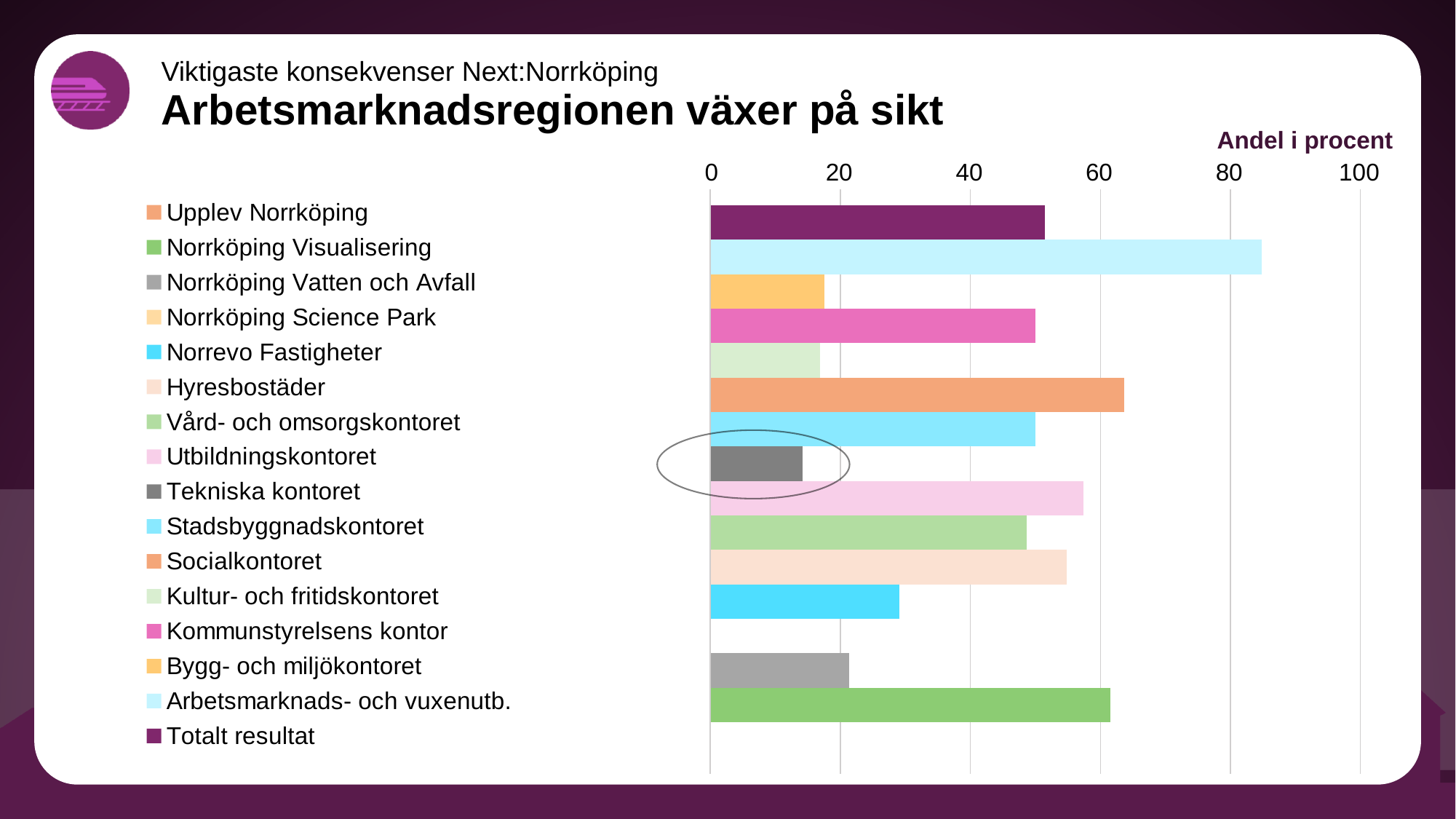
Is the value for Totalt resultat greater or less than 40? greater Which category has the longest bar in the chart? Arbetsmarknads- och vuxenutb. What kind of chart is shown on the slide? bar chart Is the value for Norrevo Fastigheter greater or less than 40? less Is the value for Tekniska kontoret greater or less than 20? less What is the highest tick value shown on the horizontal axis? 100 How many entries does the chart legend list? 16 Which is larger, the value for Socialkontoret or the value for Totalt resultat? Socialkontoret What is the label shown above the horizontal axis of the chart? Andel i procent Which is larger, the value for Utbildningskontoret or the value for Tekniska kontoret? Utbildningskontoret